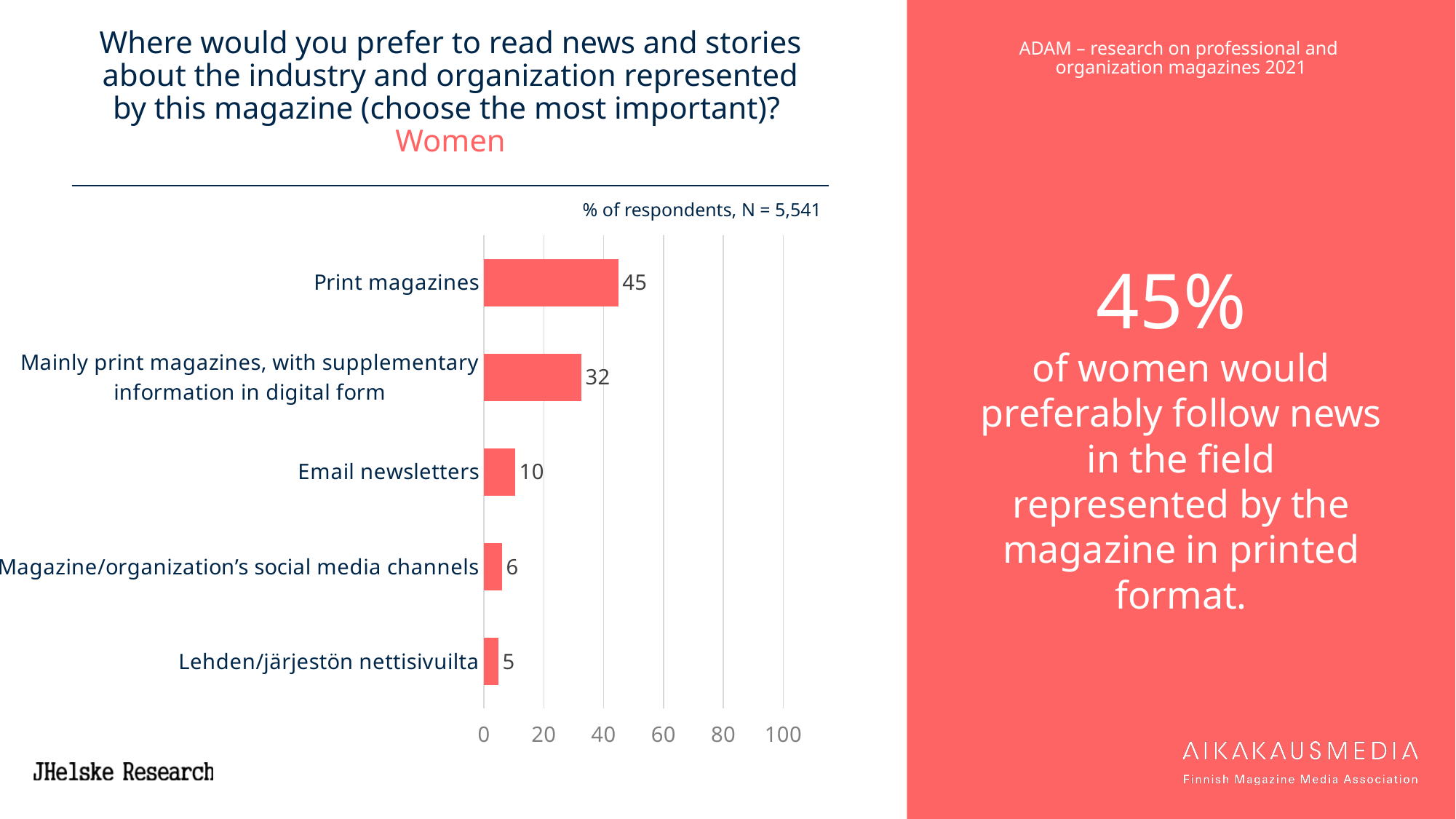
Which category has the highest value? Print magazines What is the value for Email newsletters? 10 Which is larger: the value for Email newsletters or for Magazine/organization's social media channels? Email newsletters What is the sample size (N) stated above the chart? 5,541 What is the difference between the values for Print magazines and Email newsletters? 35 What is the value for 'Mainly print magazines, with supplementary information in digital form'? 32 What kind of chart is shown on the slide? Bar chart Which category has the lowest value? Lehden/järjestön nettisivuilta How many categories are shown in the chart? 5 What is the value for Magazine/organization's social media channels? 6 What percentage of women respondents prefer print magazines? 45 Is the value for Print magazines greater or less than 40? greater